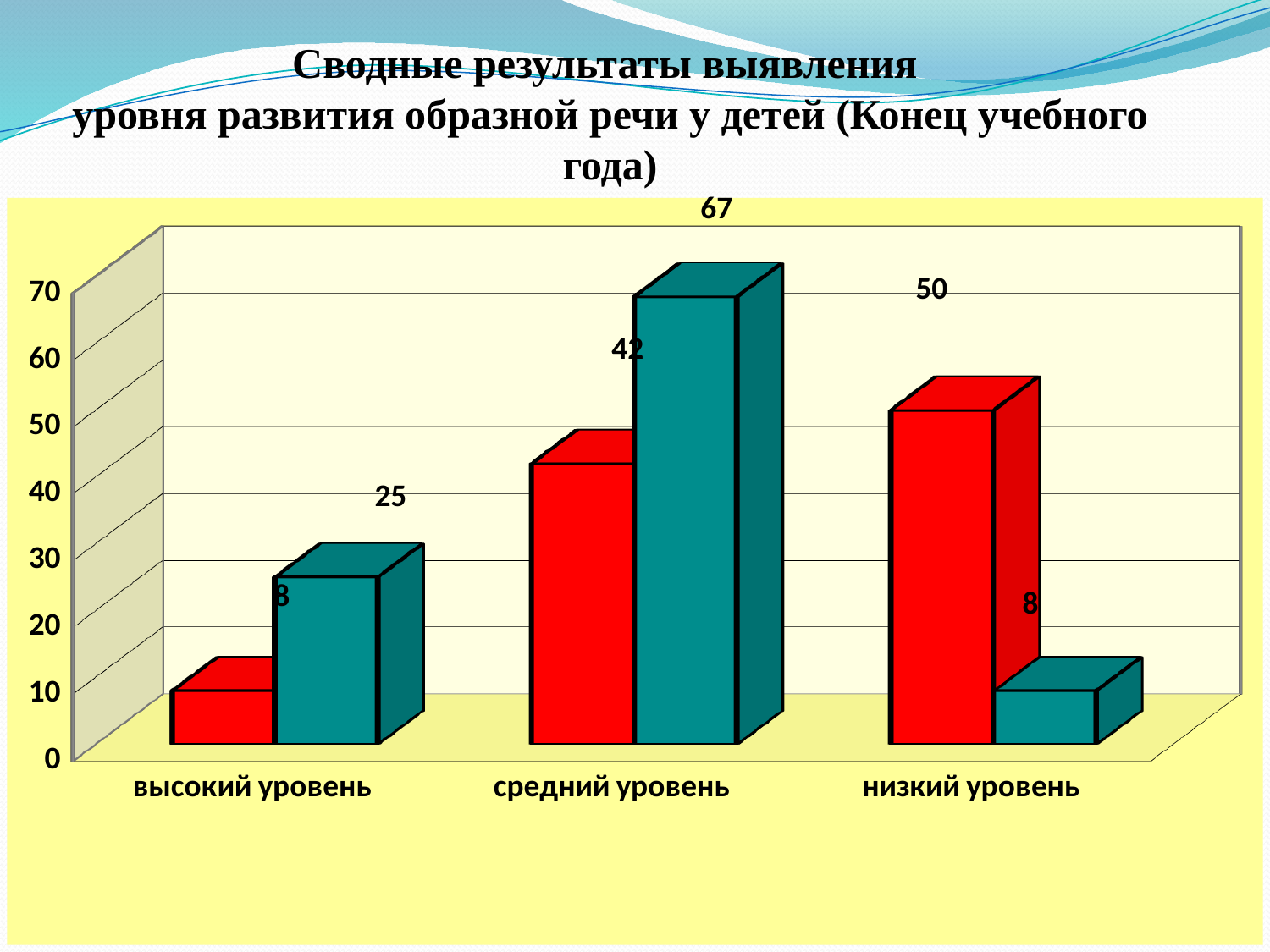
Which category has the highest teal bar? средний уровень What is the value of the red bar for низкий уровень? 50 For низкий уровень, which bar is larger, the red or the teal? red How many categories are shown on the x axis? 3 Which category has the lowest red bar? высокий уровень What kind of chart is shown on the slide? bar chart What is the difference between the red bars for низкий уровень and высокий уровень? 42 What is the value of the red bar for средний уровень? 42 What is the value of the teal bar for низкий уровень? 8 What is the value of the teal bar for высокий уровень? 25 What is the highest value shown on the vertical axis? 70 What is the difference between the teal and red bars for средний уровень? 25